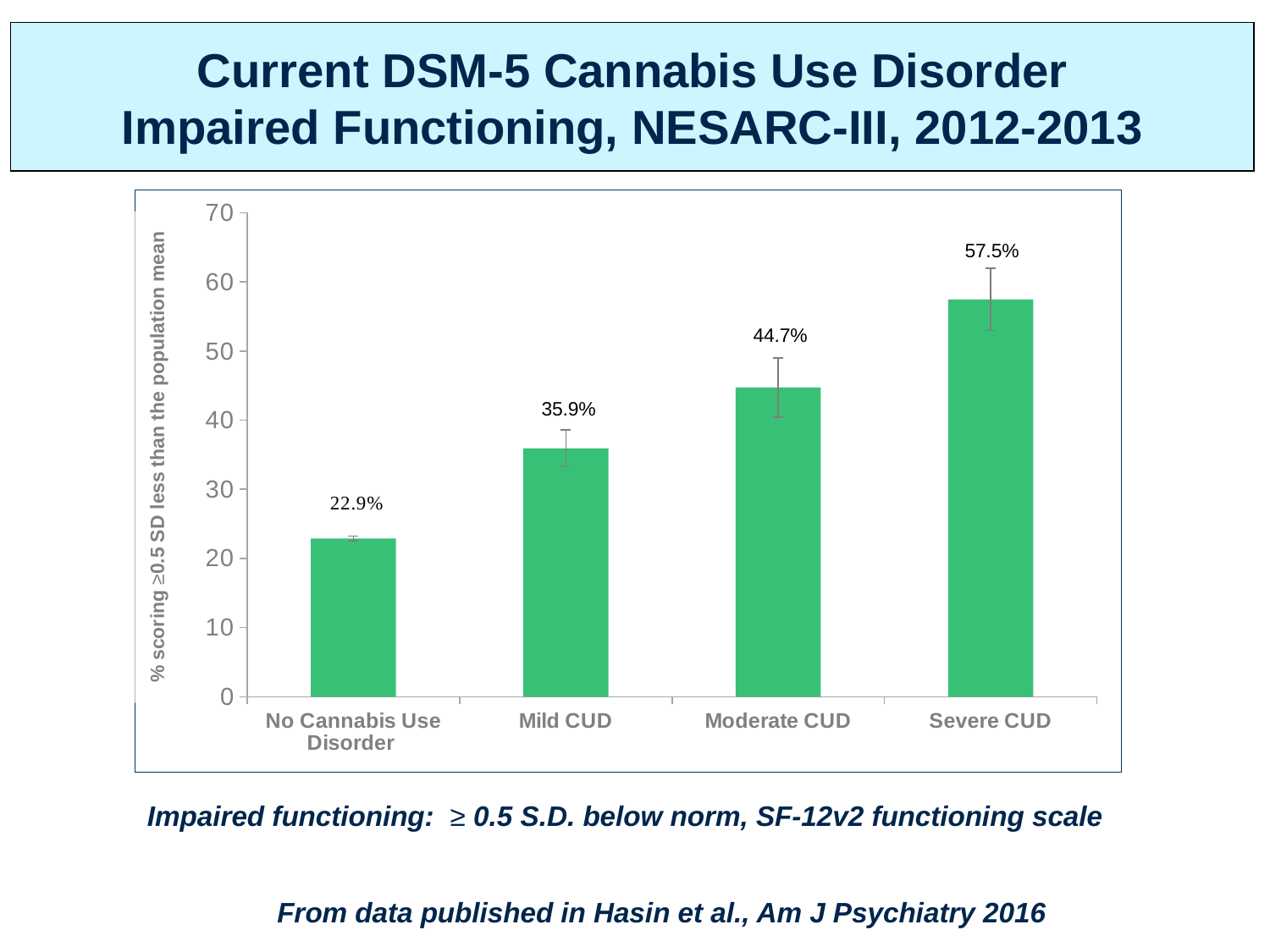
What is the value for Mild CUD? 35.9% Which is larger, the value for Mild CUD or the value for Moderate CUD? Moderate CUD What kind of chart is shown on the slide? Bar chart What is the value for Severe CUD? 57.5% Do the values rise or fall from left to right along the x axis? Rise What is the difference between the values for Moderate CUD and Mild CUD? 8.8% What is the value for Moderate CUD? 44.7% Which category has the highest value? Severe CUD Which category has the lowest value? No Cannabis Use Disorder What is the value for No Cannabis Use Disorder? 22.9% What is the difference between the values for Severe CUD and No Cannabis Use Disorder? 34.6% How many categories are shown on the x axis? 4